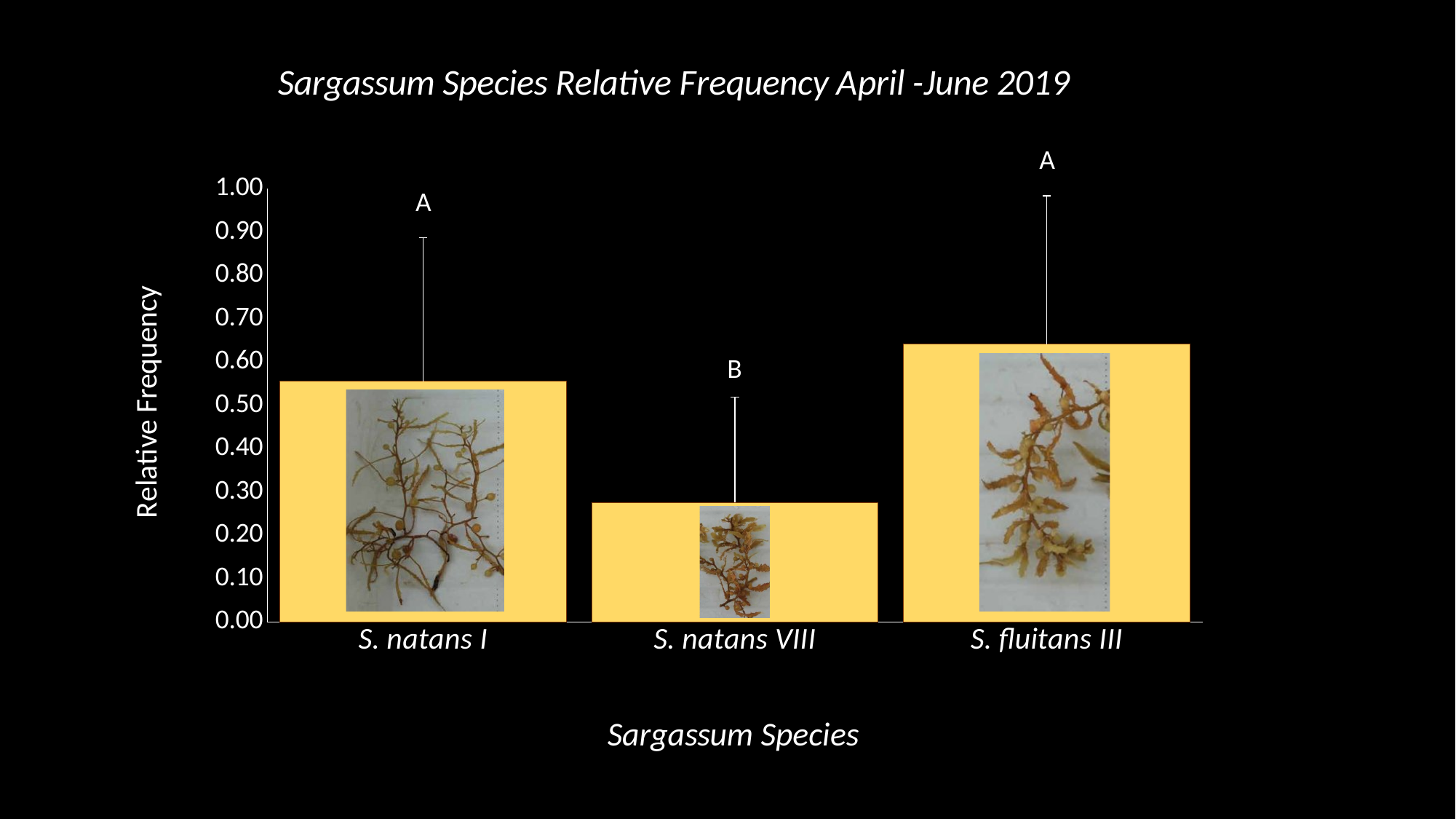
Is the relative frequency for S. natans I greater or less than 0.50? greater Which has a higher relative frequency, S. natans I or S. fluitans III? S. fluitans III What is the title of the chart? Sargassum Species Relative Frequency April -June 2019 How many species categories are plotted on the x axis? 3 What kind of chart is shown on the slide? bar chart Is the relative frequency for S. fluitans III greater or less than 0.60? greater Which has a higher relative frequency, S. natans I or S. natans VIII? S. natans I What letter is printed above the S. natans VIII bar? B Is the relative frequency for S. natans VIII greater or less than 0.30? less Which species has the lowest relative frequency? S. natans VIII Which species has the highest relative frequency? S. fluitans III What is the label of the y axis? Relative Frequency